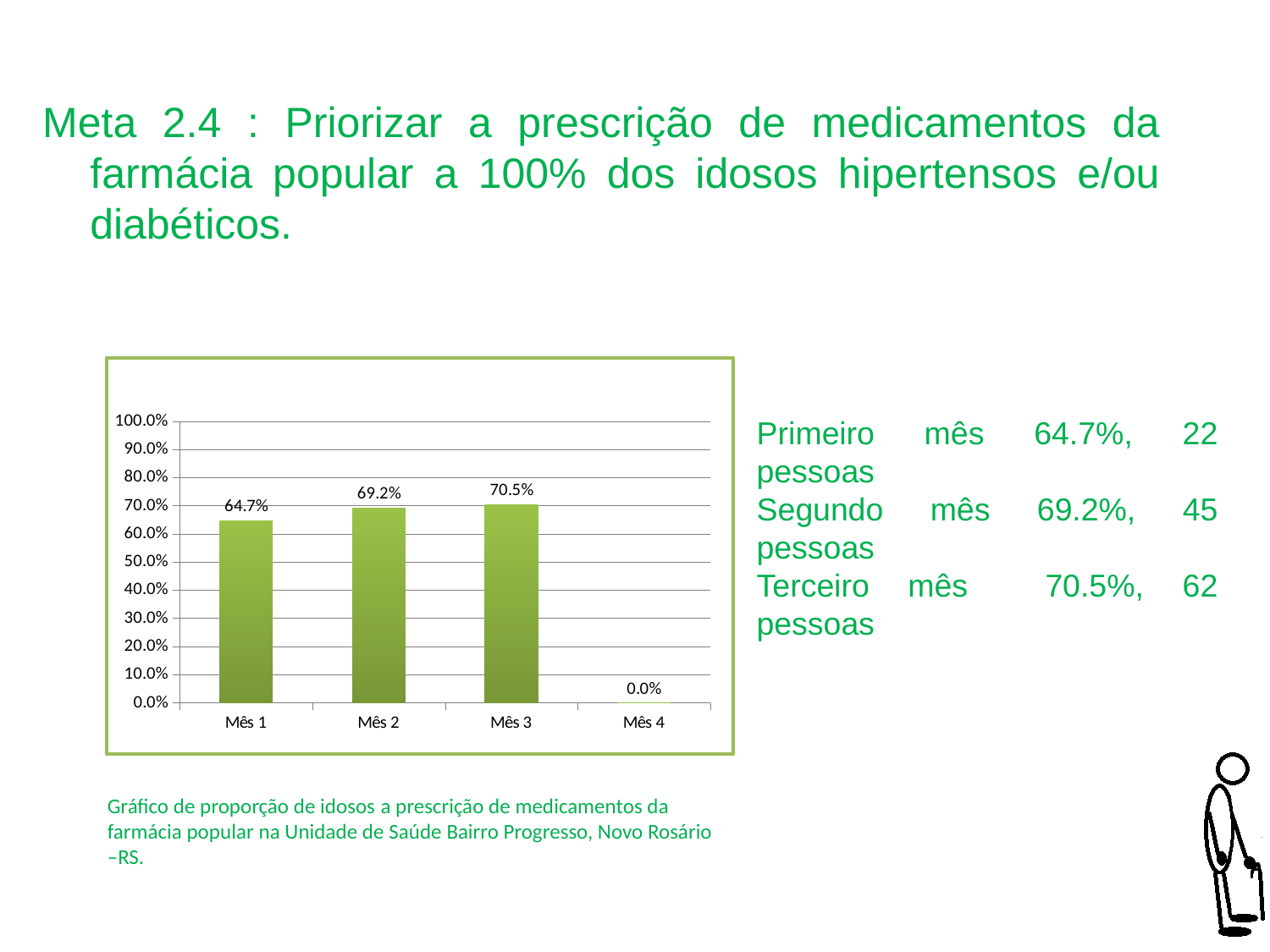
What is the value for Mês 3? 70.5% What is the value for Mês 2? 69.2% What is the value for Mês 1? 64.7% Which is larger, the value for Mês 1 or the value for Mês 2? Mês 2 Is the value for Mês 2 greater or less than 60.0%? greater What is the value for Mês 4? 0.0% What kind of chart is shown? bar chart What is the difference between the values for Mês 3 and Mês 1? 5.8% How many months are shown on the x axis? 4 Do the values rise or fall from Mês 1 to Mês 3? rise Which month has the highest value? Mês 3 Which month has the lowest value? Mês 4